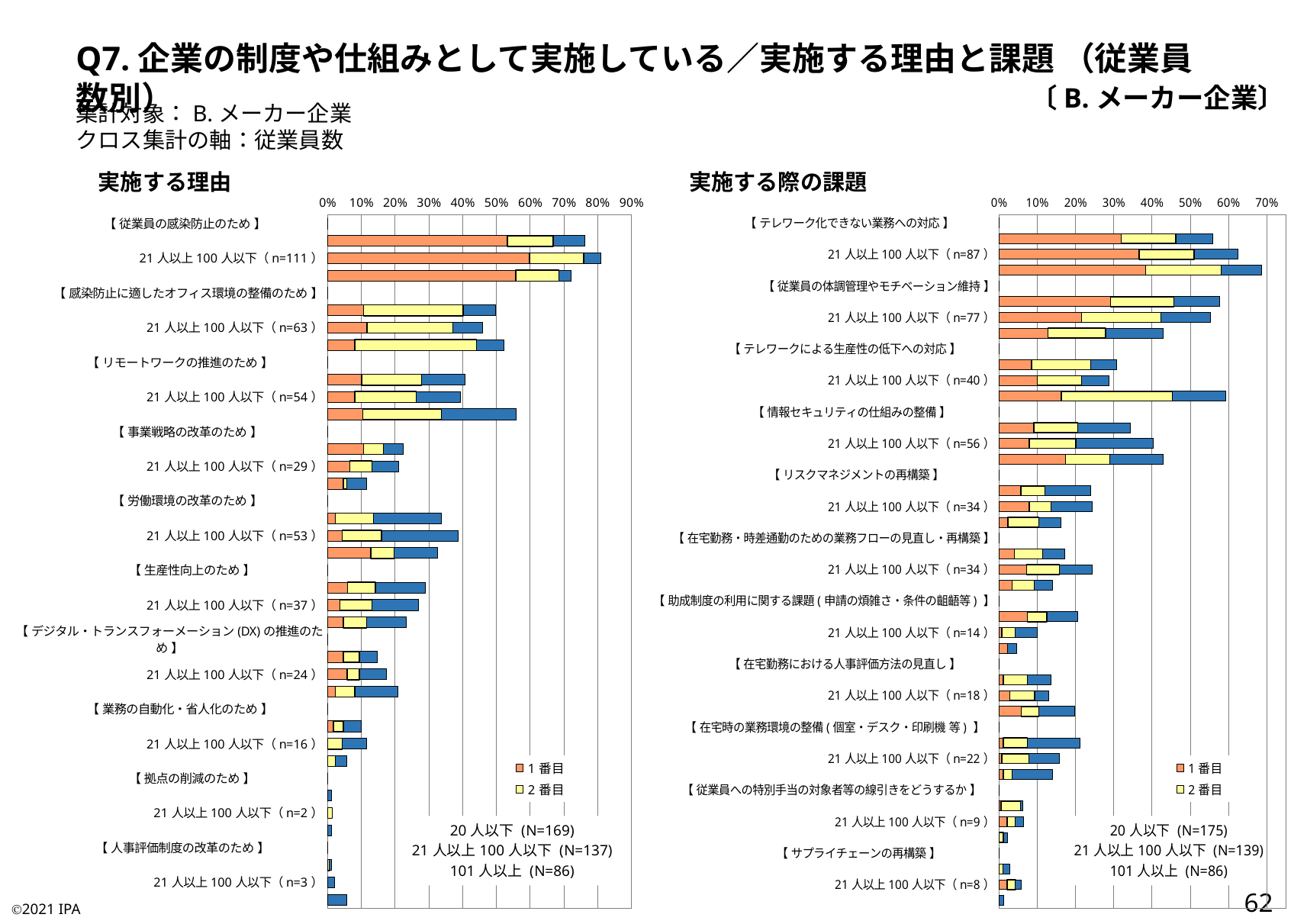
What kind of chart is the "実施する理由" chart on the left? Stacked bar chart In the "実施する理由" chart on the left, is the total bar for 21人以上100人以下 (n=63) under 感染防止に適したオフィス環境の整備のため greater or less than 50%? less In the "実施する理由" chart on the left, how many reason categories (the bracketed headings) are shown? 10 In the "実施する理由" chart on the left, is the total bar for 101人以上 under リモートワークの推進のため greater or less than 50%? greater In the "実施する際の課題" chart on the right, which issue category has the longest bar? テレワーク化できない業務への対応 In the "実施する際の課題" chart on the right, how many issue categories (the bracketed headings) are shown? 11 How many entries does the legend of the "実施する際の課題" chart on the right list? 2 In the "実施する理由" chart on the left, which reason category has the longest bars? 従業員の感染防止のため In the "実施する際の課題" chart on the right, is the total bar for 20人以下 under リスクマネジメントの再構築 greater or less than 30%? less What is the highest percentage tick shown on the x axis of the "実施する際の課題" chart on the right? 70%